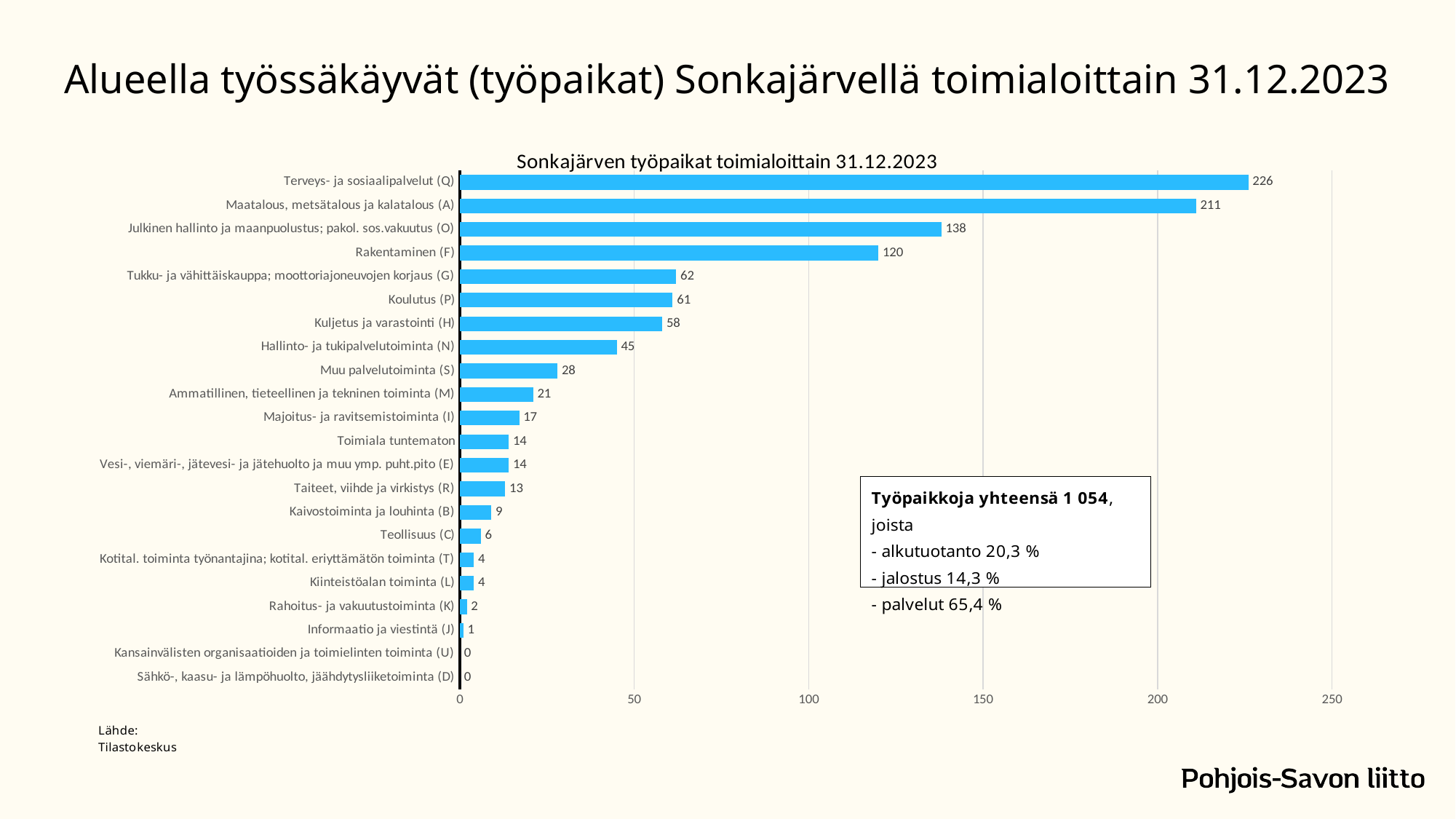
What is the value for Terveys- ja sosiaalipalvelut (Q)? 226 What is the difference between Terveys- ja sosiaalipalvelut (Q) and Maatalous, metsätalous ja kalatalous (A)? 15 What is the value for Rakentaminen (F)? 120 Which is larger, Hallinto- ja tukipalvelutoiminta (N) or Muu palvelutoiminta (S)? Hallinto- ja tukipalvelutoiminta (N) Which category has the highest value? Terveys- ja sosiaalipalvelut (Q) How many categories are shown in the chart? 22 What is the title of the chart? Sonkajärven työpaikat toimialoittain 31.12.2023 What is the value for Koulutus (P)? 61 What is the difference between Julkinen hallinto ja maanpuolustus; pakol. sos.vakuutus (O) and Rakentaminen (F)? 18 Is the value for Maatalous, metsätalous ja kalatalous (A) greater or less than 200? greater What is the value for Kaivostoiminta ja louhinta (B)? 9 What kind of chart is shown on the slide? Bar chart